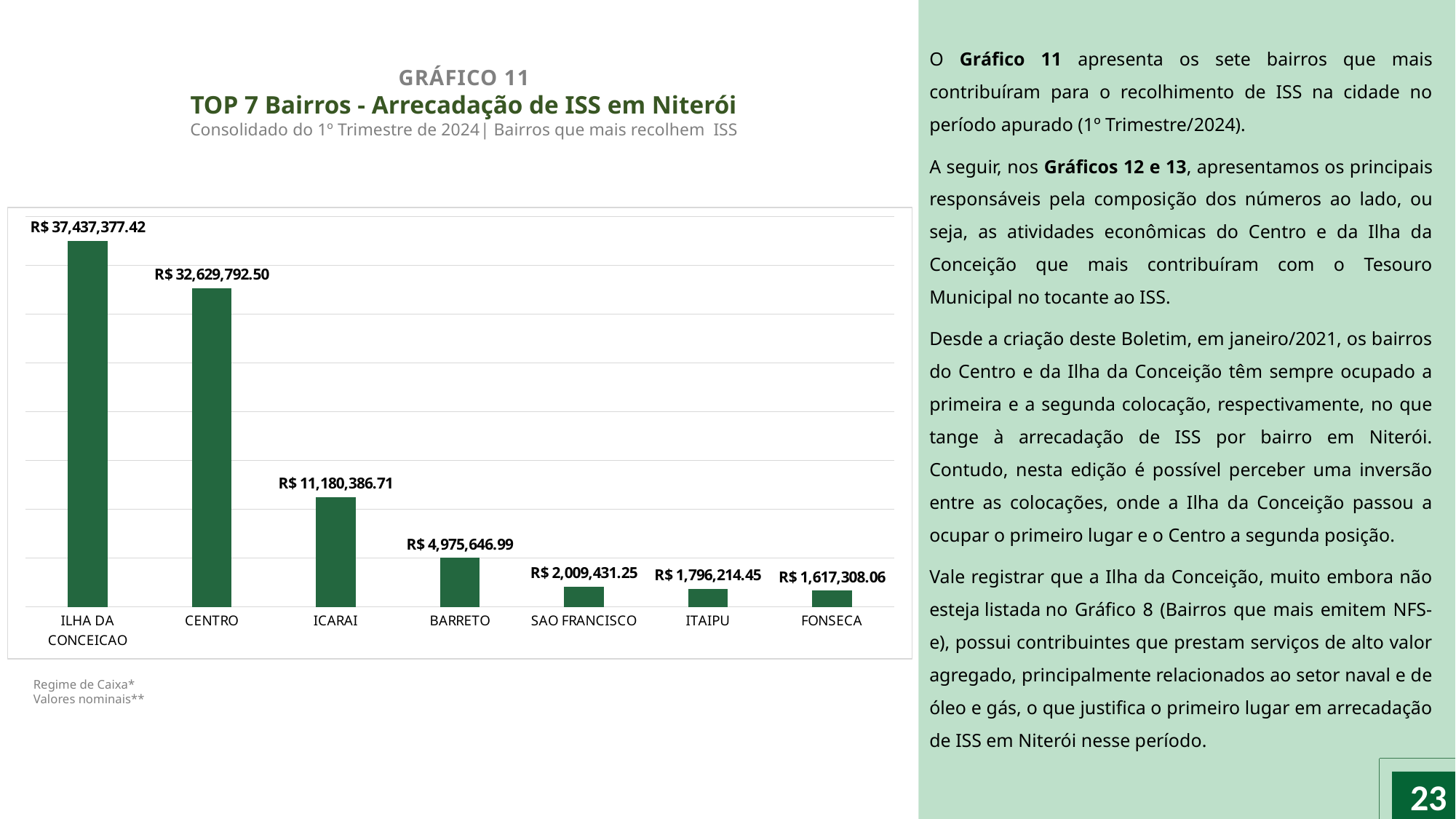
What is the value shown for FONSECA? R$ 1,617,308.06 What is the difference between the values for ITAIPU and FONSECA? R$ 178,906.39 What is the value shown for ICARAI? R$ 11,180,386.71 What is the value shown for SAO FRANCISCO? R$ 2,009,431.25 Which bairro has the lowest ISS collection in the chart? FONSECA Do the values rise or fall from left to right across the bairros? Fall What is the difference between the values for ILHA DA CONCEICAO and CENTRO? R$ 4,807,584.92 What is the ISS collection value for CENTRO? R$ 32,629,792.50 Which has a larger value, BARRETO or ICARAI? ICARAI What kind of chart is shown on the slide? Bar chart Which bairro has the highest ISS collection in the chart? ILHA DA CONCEICAO How many bairros are shown in the chart? 7